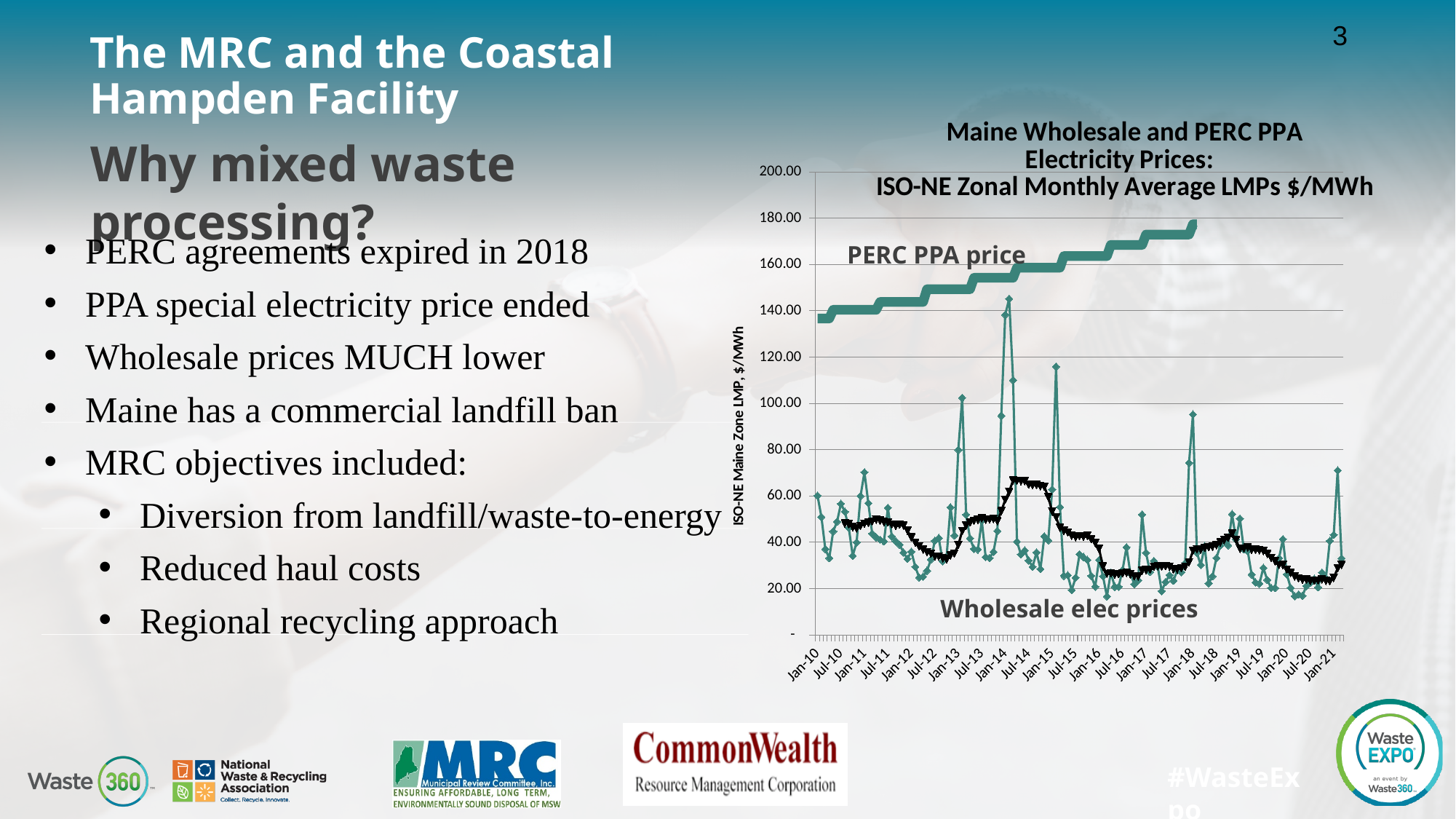
Does the PERC PPA price rise or fall from Jan-10 to Jan-18? rise Is the wholesale electricity price at Jul-20 greater or less than 60.00? less Is the PERC PPA price at its final point (around Jan-18) greater or less than 160.00? greater What is the label on the vertical axis of the chart? ISO-NE Maine Zone LMP, $/MWh Is the wholesale electricity price at Jan-10 greater or less than 80.00? less What kind of chart is shown on the slide? line chart What is the title of the chart? Maine Wholesale and PERC PPA Electricity Prices: ISO-NE Zonal Monthly Average LMPs $/MWh Which is higher throughout the chart, the PERC PPA price or the wholesale electricity price? PERC PPA price What is the highest value shown on the vertical axis of the chart? 200.00